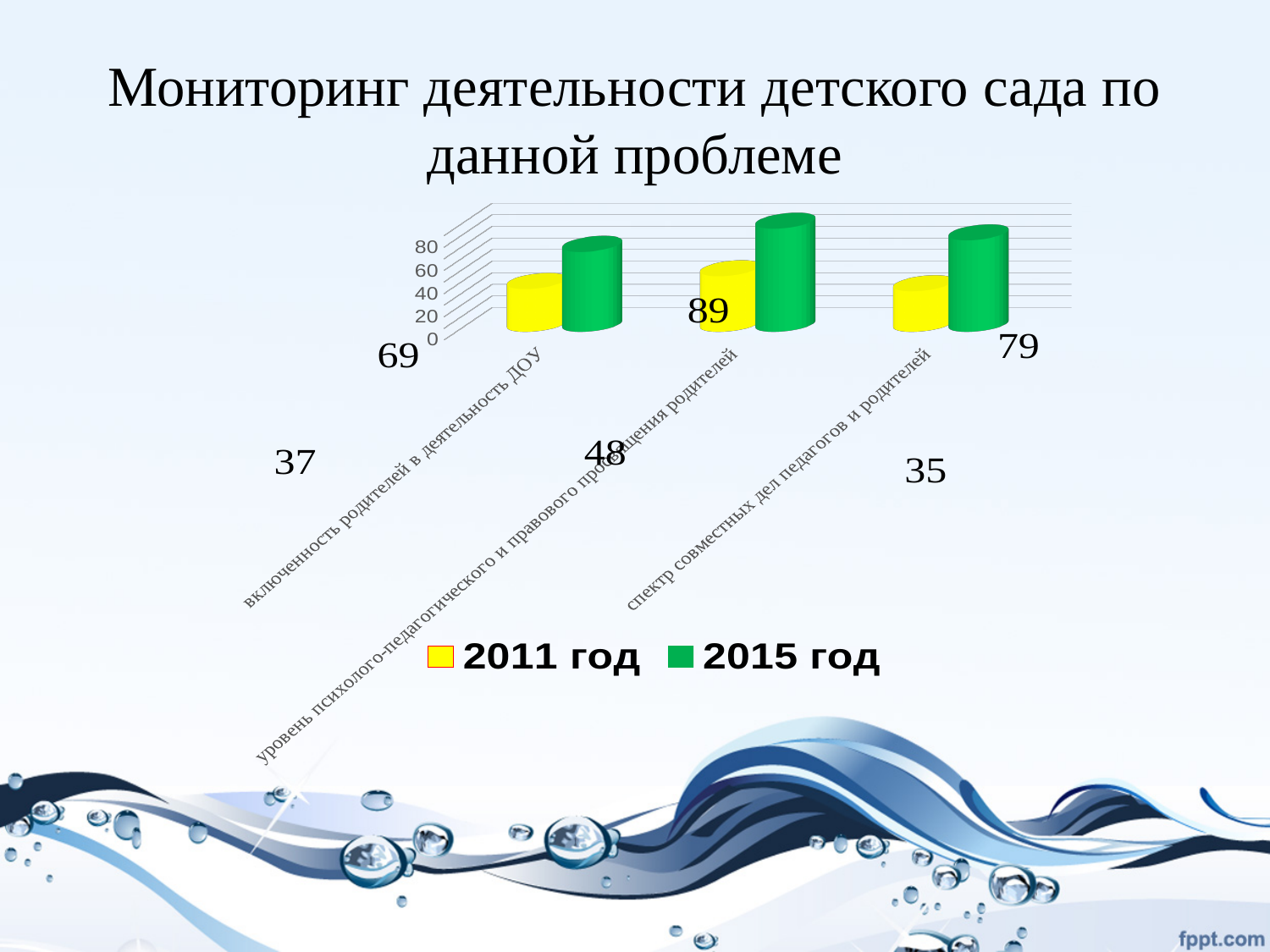
For 'включенность родителей в деятельность ДОУ', which series has the larger value, 2011 год or 2015 год? 2015 год What is the 2011 год value for 'включенность родителей в деятельность ДОУ'? 37 Is the 2015 год value for 'уровень психолого-педагогического и правового просвещения родителей' greater or less than 80? greater What kind of chart is shown on the slide? bar chart What is the 2015 год value for 'уровень психолого-педагогического и правового просвещения родителей'? 89 What is the 2015 год value for 'спектр совместных дел педагогов и родителей'? 79 How many series does the legend list? 2 Which category has the highest 2015 год value? уровень психолого-педагогического и правового просвещения родителей Which category has the lowest 2011 год value? спектр совместных дел педагогов и родителей How many categories are shown on the x axis of the chart? 3 Which colour represents the 2015 год series? green What are the two series named in the legend? 2011 год and 2015 год